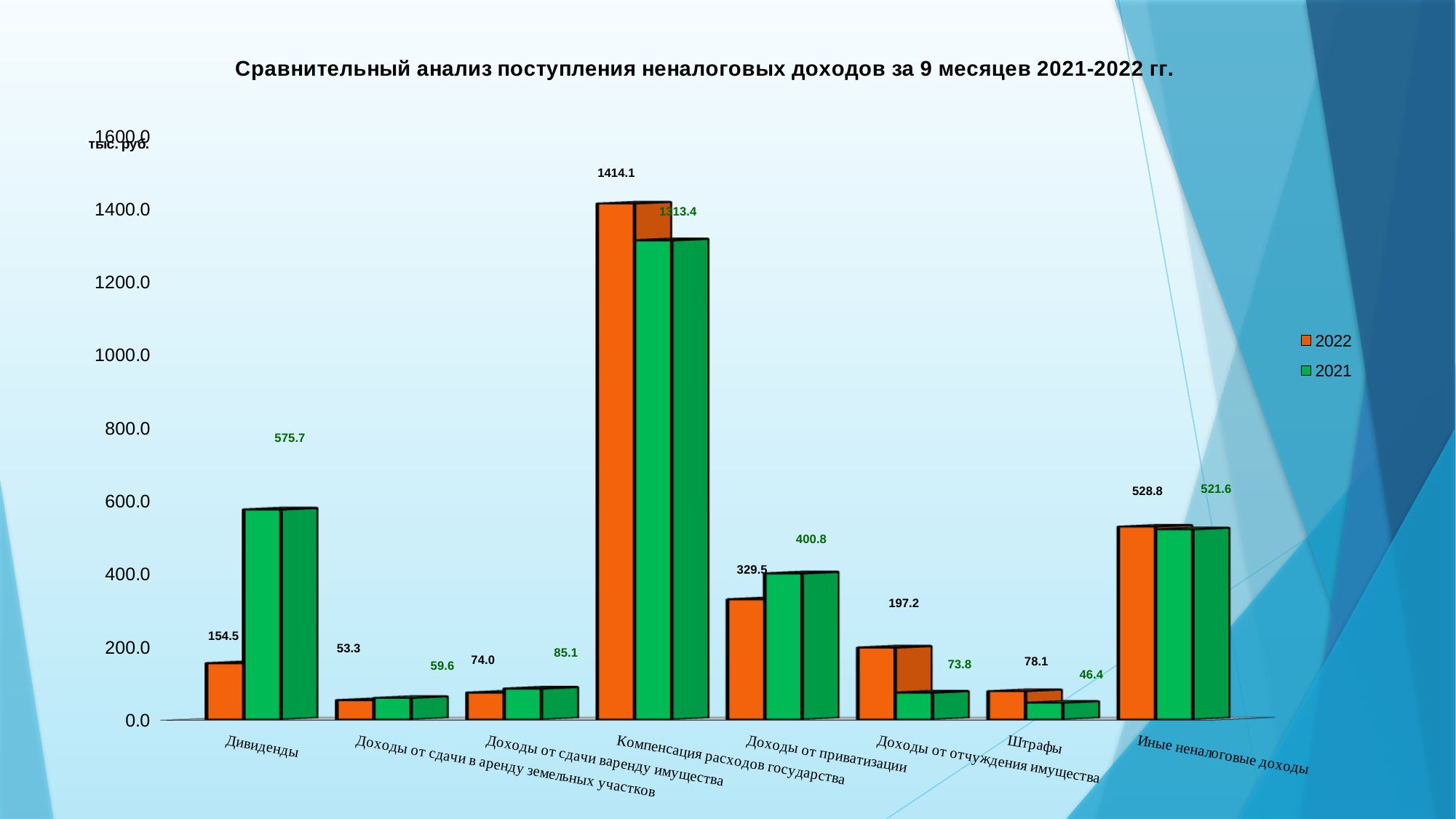
What is the 2022 value for Компенсация расходов государства? 1414.1 Which colour represents the 2022 series in the legend? orange How many series does the legend list? 2 What is the difference between the 2022 and 2021 values for Доходы от отчуждения имущества? 123.4 What type of chart is shown on the slide? bar chart What is the 2021 value for Дивиденды? 575.7 Which category has the highest 2021 value? Компенсация расходов государства What is the 2022 value for Штрафы? 78.1 Is the 2022 value for Иные неналоговые доходы greater or less than 400.0? greater Which is larger for Доходы от приватизации, the 2022 value or the 2021 value? 2021 Which category has the lowest 2022 value? Доходы от сдачи в аренду земельных участков How many categories are shown on the x axis? 8